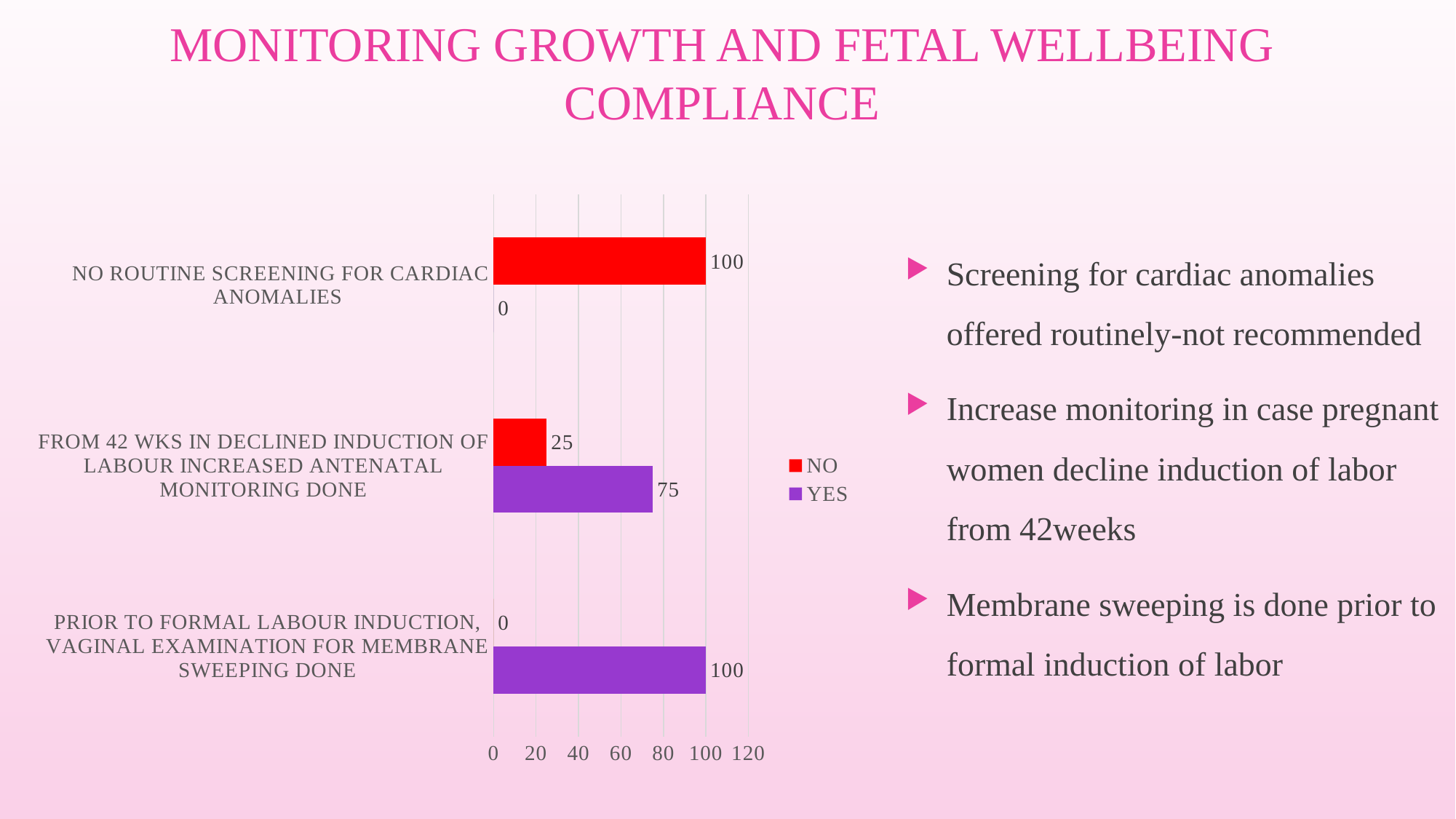
What is the NO value for 'No routine screening for cardiac anomalies'? 100 What is the YES value for 'No routine screening for cardiac anomalies'? 0 What is the difference between the YES and NO values for 'From 42 wks in declined induction of labour increased antenatal monitoring done'? 50 What is the NO value for 'From 42 wks in declined induction of labour increased antenatal monitoring done'? 25 For 'From 42 wks in declined induction of labour increased antenatal monitoring done', which is larger, YES or NO? YES Which category has the lowest NO value? Prior to formal labour induction, vaginal examination for membrane sweeping done How many series does the legend list? 2 What type of chart is shown on the slide? Bar chart What is the NO value for 'Prior to formal labour induction, vaginal examination for membrane sweeping done'? 0 What is the YES value for 'Prior to formal labour induction, vaginal examination for membrane sweeping done'? 100 Which category has the highest YES value? Prior to formal labour induction, vaginal examination for membrane sweeping done What is the YES value for 'From 42 wks in declined induction of labour increased antenatal monitoring done'? 75